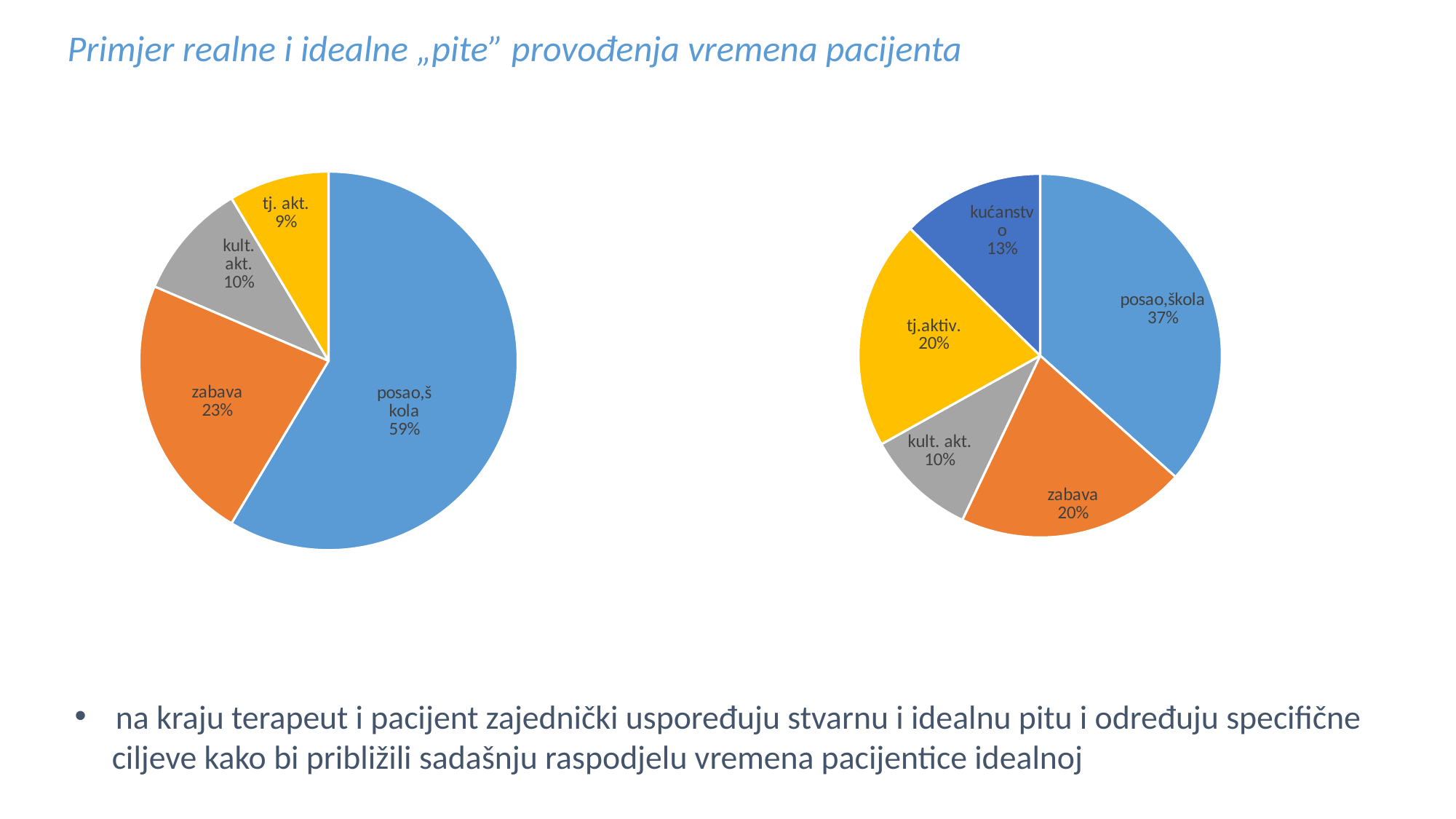
How many slices does the right pie chart have? 5 In the right pie chart, what share does the "posao,škola" slice have? 37% In the right pie chart, what share does the "kućanstvo" slice have? 13% What type of chart is shown on the left of the slide? pie chart In the left pie chart, is the "zabava" slice larger or smaller than the "kult. akt." slice? larger In the left pie chart, what share does the "zabava" slice have? 23% What is the difference between the "posao,škola" share in the left pie chart and in the right pie chart? 22% In the left pie chart, what share does the "posao,škola" slice have? 59% In the right pie chart, which category has the smallest slice? kult. akt. In the right pie chart, which category has the largest slice? posao,škola How many slices does the left pie chart have? 4 In the left pie chart, which category has the smallest slice? tj. akt.